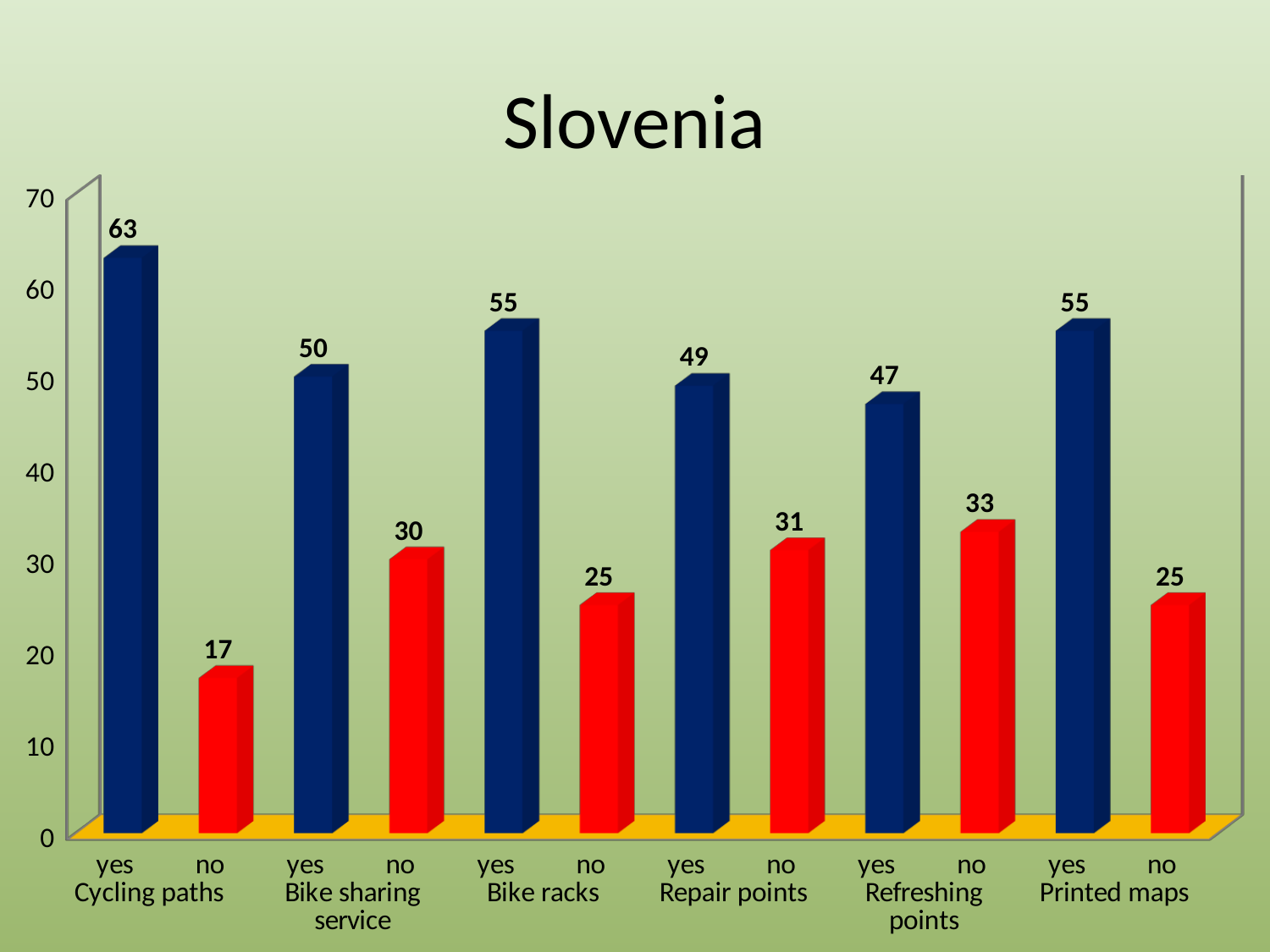
Is the 'yes' value for Refreshing points greater or less than 40? greater What is the value for 'no' under Bike sharing service? 30 What is the value for 'yes' under Cycling paths? 63 What colour are the 'no' bars? red What is the value for 'no' under Refreshing points? 33 Which is larger: the 'no' value for Bike sharing service or the 'no' value for Bike racks? no, Bike sharing service Which bar has the highest value on the chart? yes, Cycling paths How many bars are plotted on the chart? 12 Which bar has the lowest value on the chart? no, Cycling paths What kind of chart is shown on the slide? bar chart What is the title of the chart? Slovenia What is the difference between the 'yes' and 'no' values for Repair points? 18